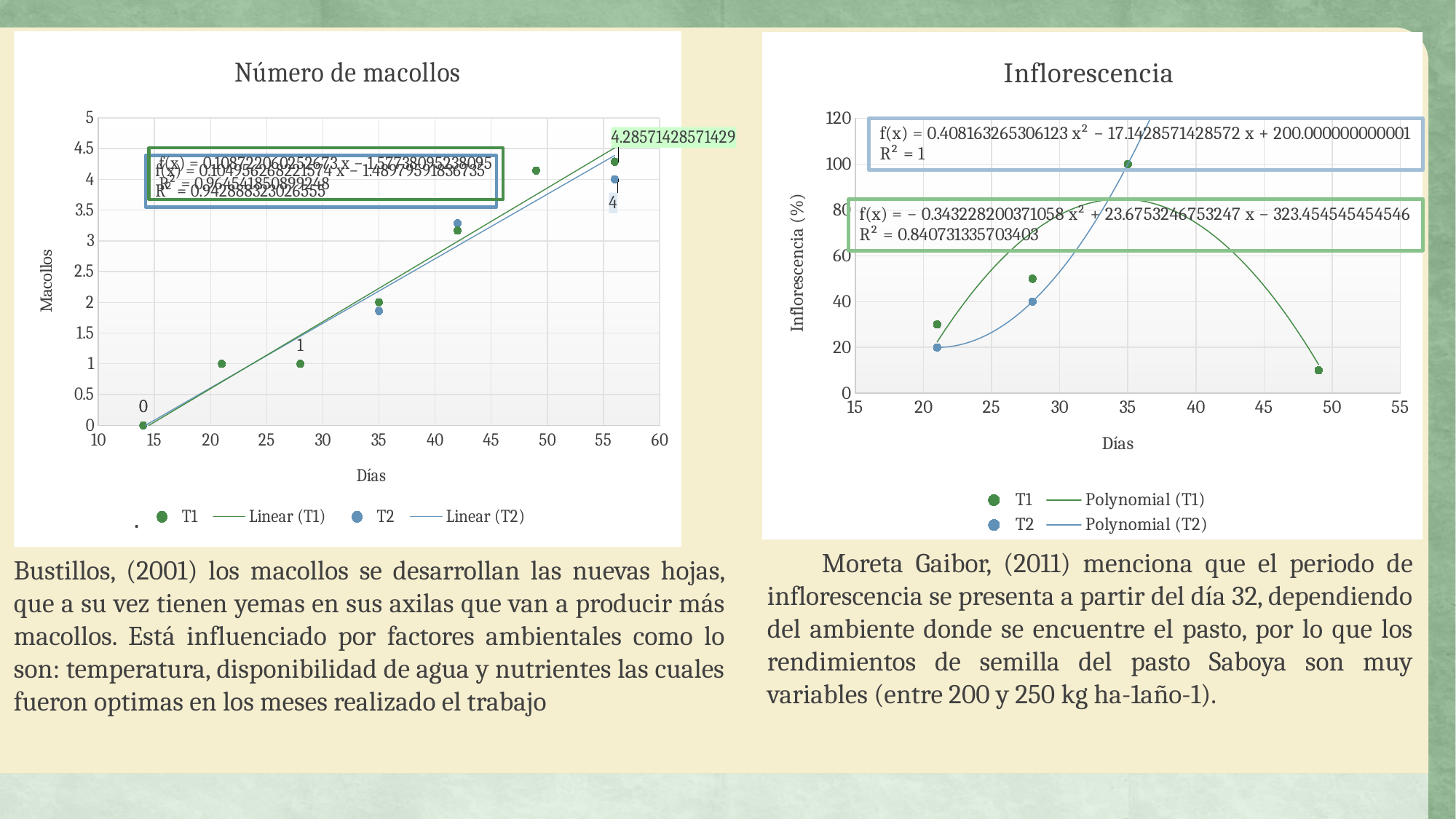
What is the y-axis title of the 'Inflorescencia' chart? Inflorescencia (%) What kind of chart is the 'Número de macollos' chart? scatter chart In the 'Inflorescencia' chart, what is the R² value shown for the T2 polynomial trendline? 1 In the 'Número de macollos' chart, do the T1 values rise or fall as the days increase? rise In the 'Inflorescencia' chart, is the T1 value at day 49 greater or less than 20? less In the 'Número de macollos' chart, what is the labelled T2 value at day 56? 4 How many entries does the legend of the 'Número de macollos' chart list? 4 In the 'Inflorescencia' chart, is the T1 value at day 35 greater or less than 80? greater In the 'Número de macollos' chart, what is the labelled T1 value at day 56? 4.28571428571429 In the 'Inflorescencia' chart, at day 28, which series has the larger value, T1 or T2? T1 In the 'Número de macollos' chart, what is the lowest labelled value? 0 In the 'Número de macollos' chart, is the T1 value at day 49 greater or less than 3.5? greater